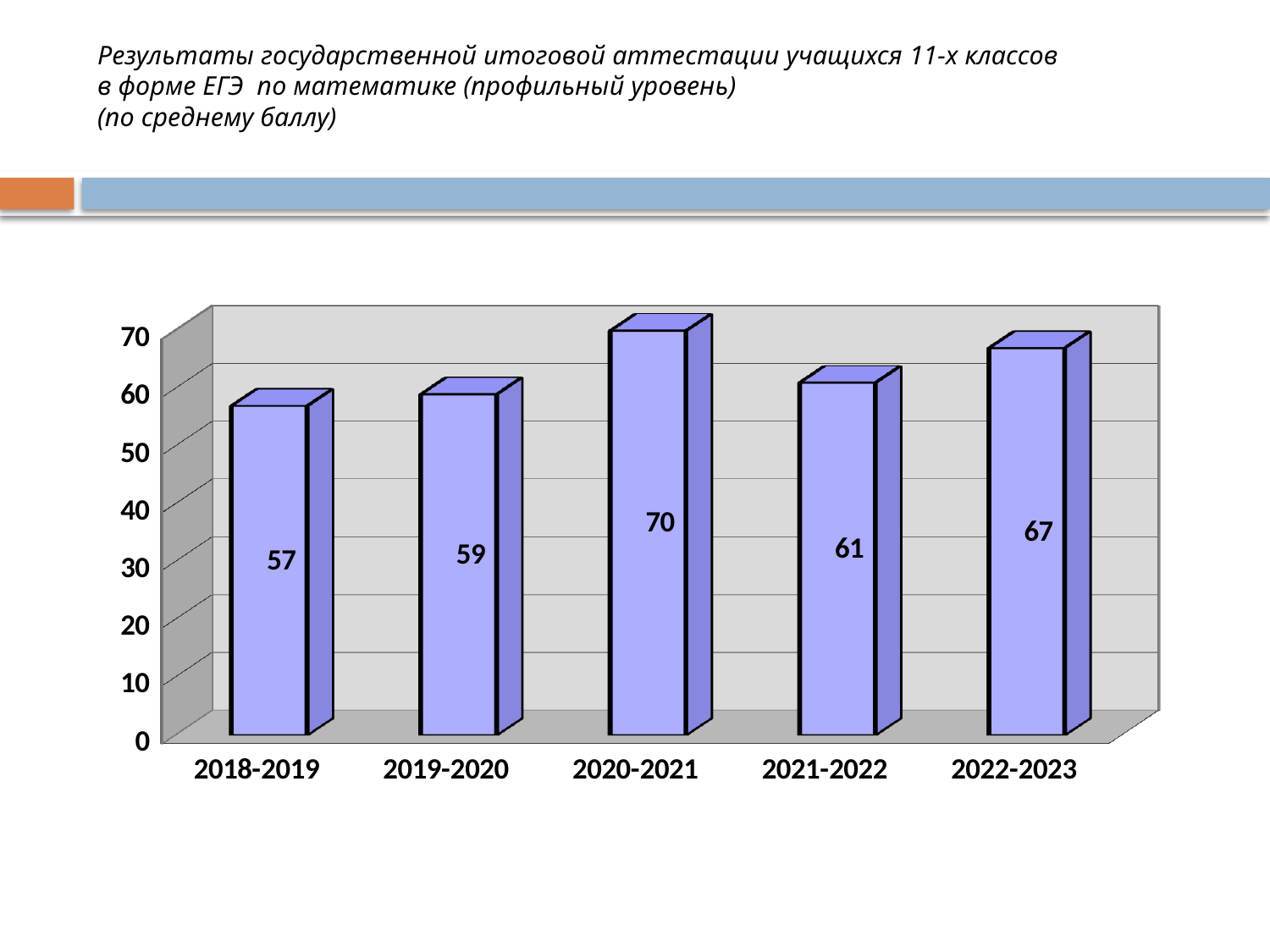
Which is larger, the value for 2019-2020 or the value for 2022-2023? 2022-2023 What is the value for 2020-2021? 70 What is the value for 2021-2022? 61 What is the value for 2022-2023? 67 How many years are shown on the x axis? 5 What is the value for 2018-2019? 57 Which year has the highest value? 2020-2021 Does the value rise or fall from 2021-2022 to 2022-2023? rise Which year has the lowest value? 2018-2019 What is the difference between the values for 2020-2021 and 2018-2019? 13 What kind of chart is this? bar chart What is the difference between the values for 2022-2023 and 2021-2022? 6